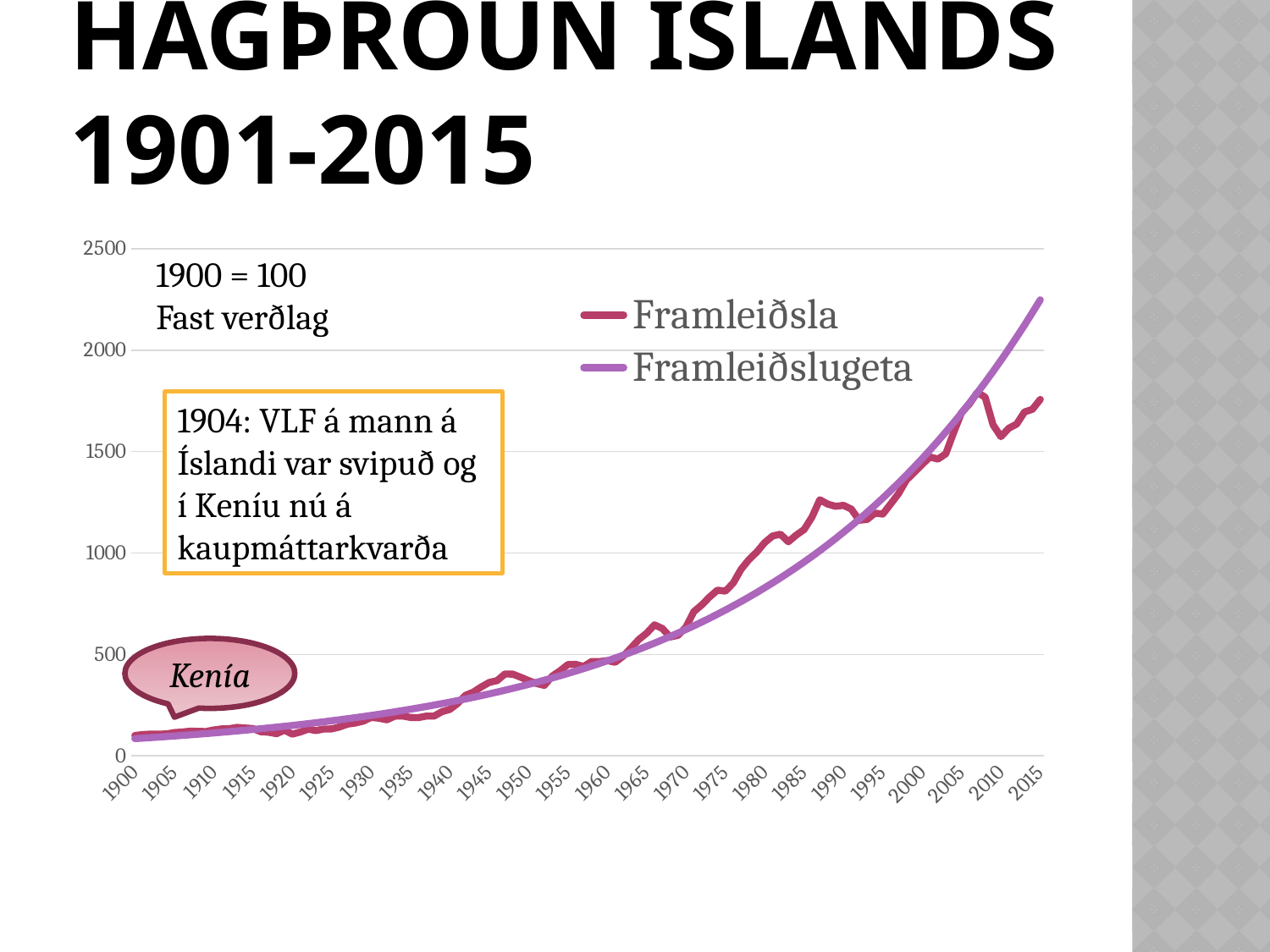
Is the value of Framleiðslugeta in 1970 greater or less than 500? greater Is the value of Framleiðsla in 1950 greater or less than 500? less Is the value of Framleiðsla in 1985 greater or less than 1000? greater How many series does the chart's legend list? 2 Does the Framleiðslugeta line rise or fall from 1900 to 2015? Rises What kind of chart is shown on the slide? Line chart In 1985, which series has the higher value, Framleiðsla or Framleiðslugeta? Framleiðsla What are the two series named in the chart's legend? Framleiðsla and Framleiðslugeta In 2010, which series has the higher value, Framleiðsla or Framleiðslugeta? Framleiðslugeta What colour is the Framleiðslugeta line in the chart? Purple